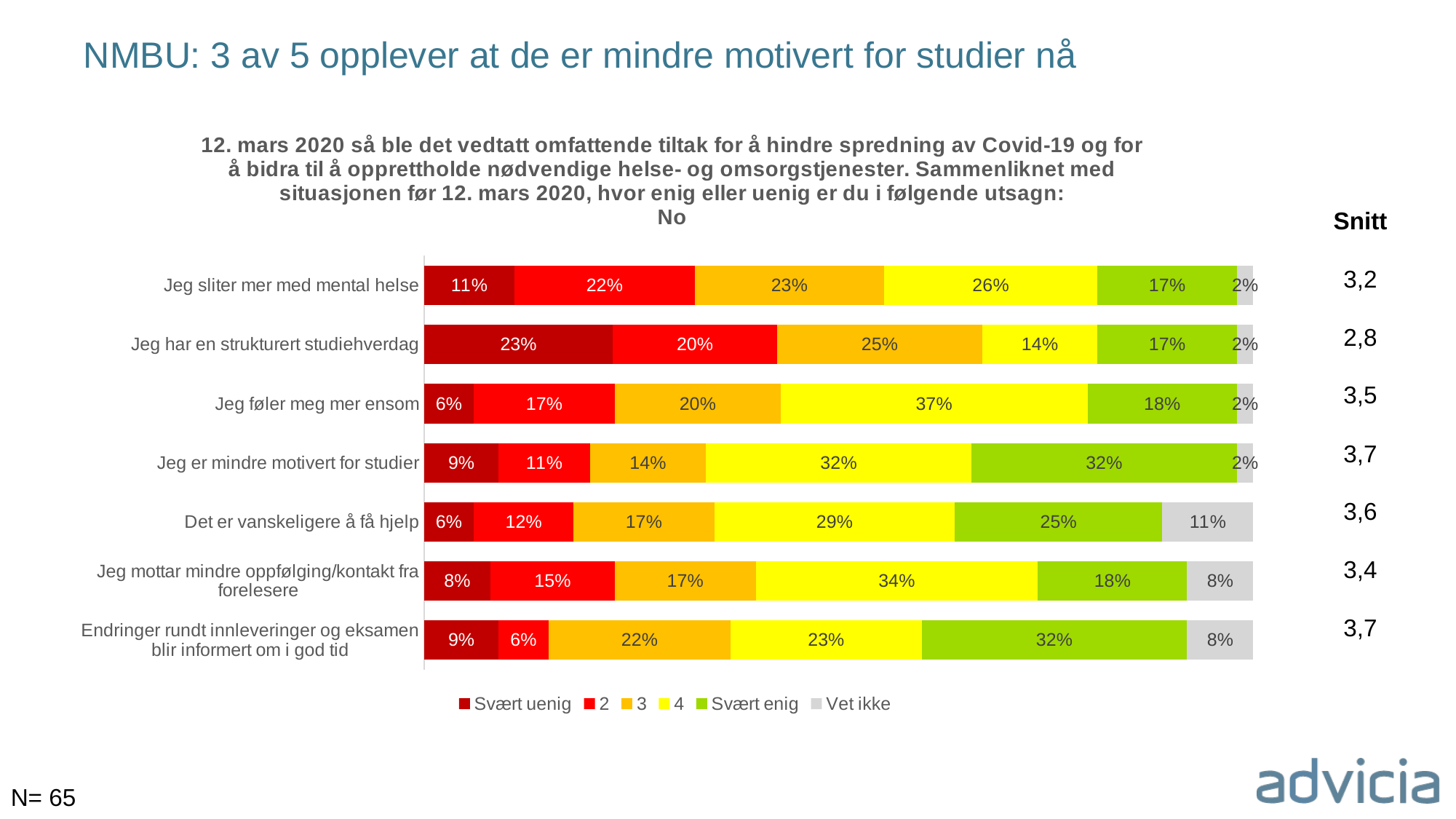
What is the 'Svært uenig' value for 'Jeg har en strukturert studiehverdag'? 23% What is the 'Vet ikke' value for 'Det er vanskeligere å få hjelp'? 11% Which is larger: the 'Svært enig' value for 'Det er vanskeligere å få hjelp' or the 'Svært enig' value for 'Jeg sliter mer med mental helse'? Det er vanskeligere å få hjelp What type of chart is shown on the slide? stacked bar chart Which statement has the lowest '2' value? Endringer rundt innleveringer og eksamen blir informert om i god tid How many series does the legend list? 6 How many statements (categories) are plotted in the chart? 7 What is the 'Svært enig' value for 'Jeg er mindre motivert for studier'? 32% Which statement has the highest 'Svært uenig' value? Jeg har en strukturert studiehverdag Which legend entry is shown in grey? Vet ikke What is the '4' value for 'Jeg føler meg mer ensom'? 37% What is the difference between the '4' value for 'Jeg føler meg mer ensom' and the '4' value for 'Jeg har en strukturert studiehverdag'? 23%